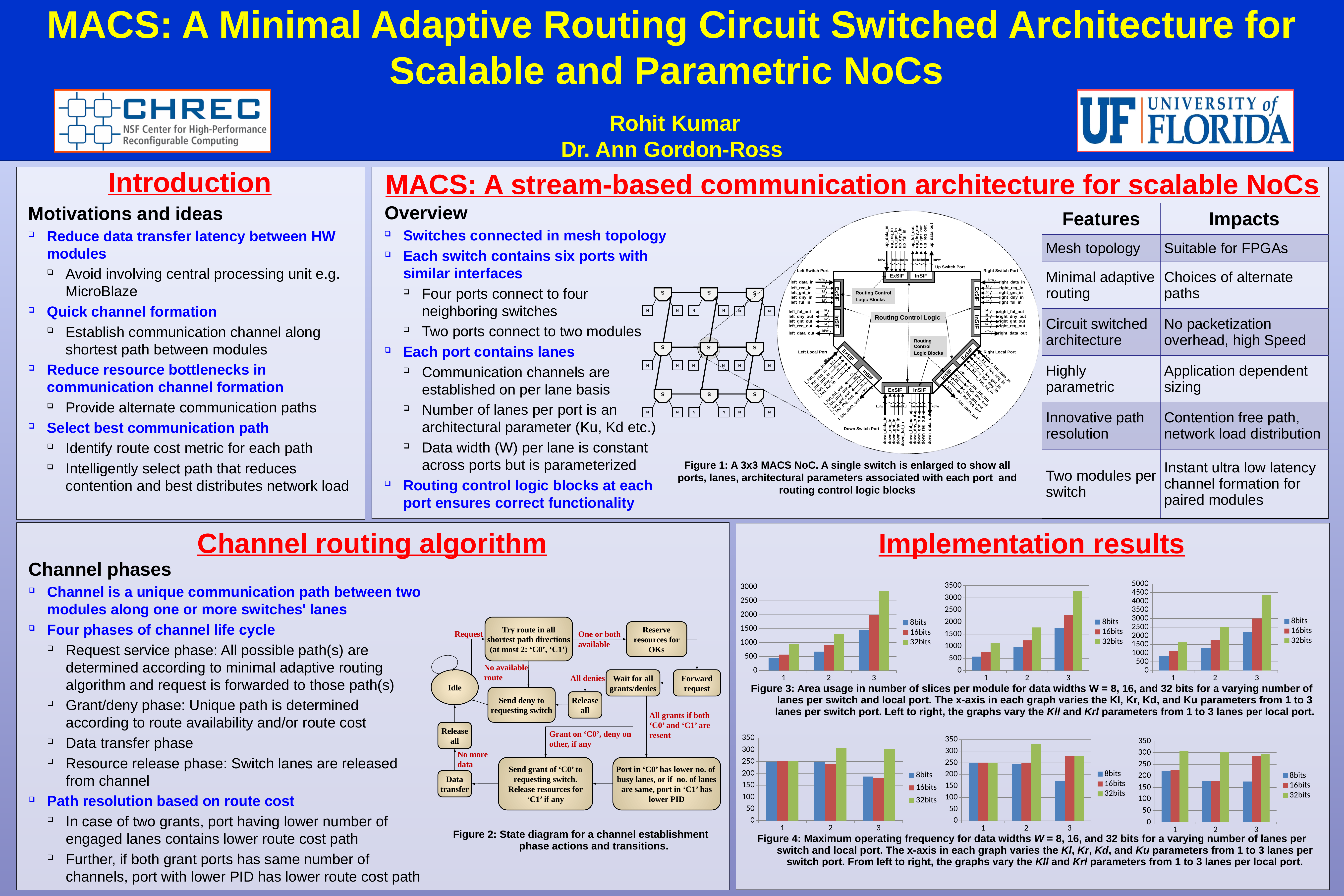
In the leftmost chart of Figure 3, do the 32bits values rise or fall from category 1 to category 3? rise In the middle chart of Figure 3, is the 32bits value at category 3 greater or less than 3000? greater In the rightmost chart of Figure 4, which is larger at category 3, the 8bits value or the 32bits value? 32bits In the leftmost chart of Figure 3, how many series does the legend list? 3 In the leftmost chart of Figure 3, how many categories are on the x-axis? 3 In the middle chart of Figure 4, is the 8bits value at category 3 greater or less than 200? less In the leftmost chart of Figure 3, which series has the tallest bar at x-axis category 3? 32bits In the leftmost chart of Figure 3, is the 32bits value at category 3 greater or less than 2500? greater In the leftmost chart of Figure 3, what kind of chart is shown? bar chart